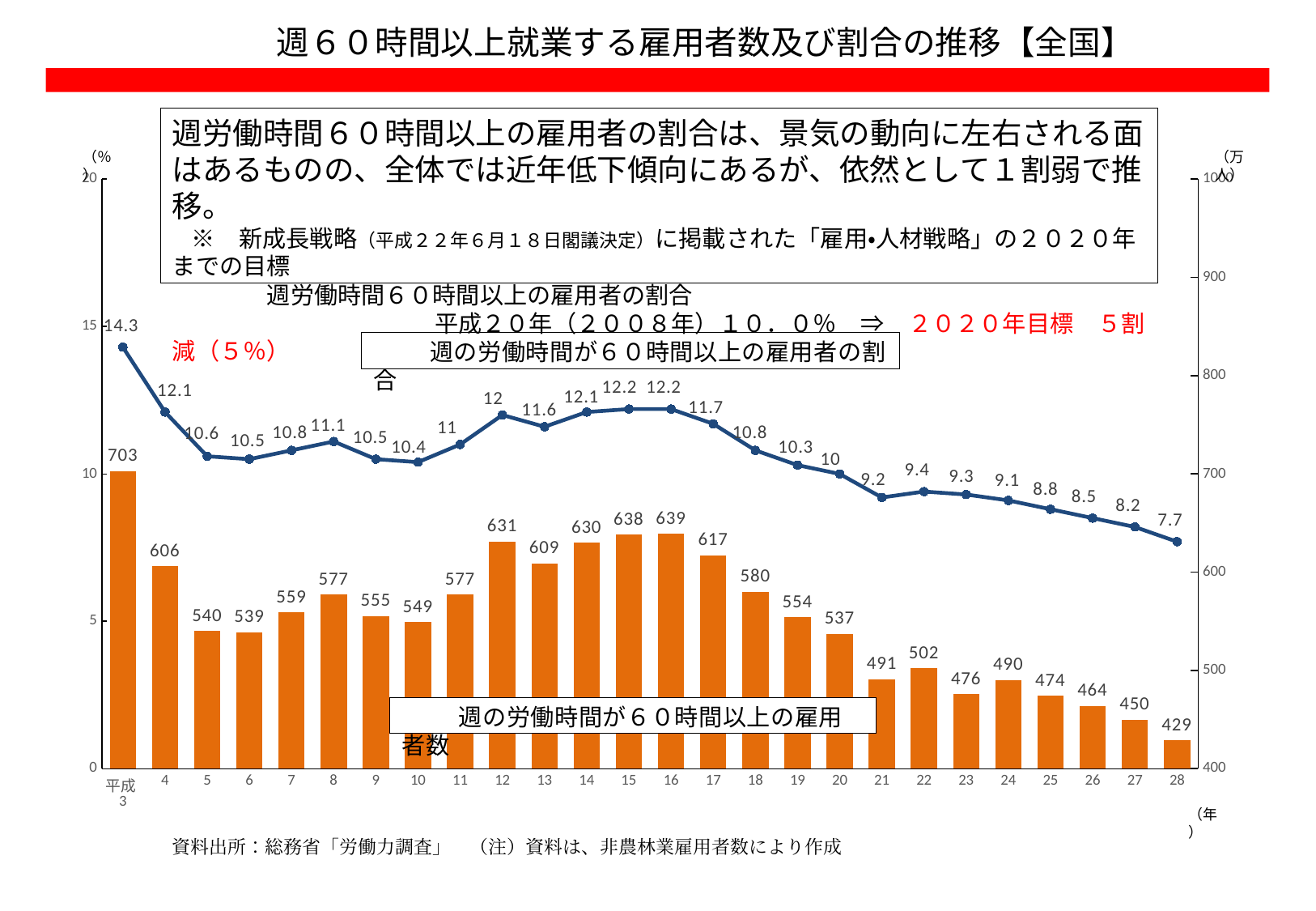
What is the unit shown on the right-hand vertical axis? 万人 What is the difference between the line values for 平成20 and 平成21? 0.8 Which year has the highest value on the line (share of employees working 60+ hours)? 平成3 What kind of chart is this? Combined bar and line chart What is the bar value for 平成3? 703 From 平成21 to 平成28, does the line (share of employees working 60+ hours) rise or fall? Fall Which is larger, the bar value for 平成12 or the bar value for 平成13? 平成12 Which year has the lowest bar value (number of employees working 60+ hours)? 平成28 What is the number of employees working 60 or more hours per week (bar) for 平成16? 639 What is the difference between the bar values for 平成3 and 平成28? 274 How many years are plotted on the x axis? 26 What is the share of employees working 60 or more hours per week (line) for 平成28? 7.7